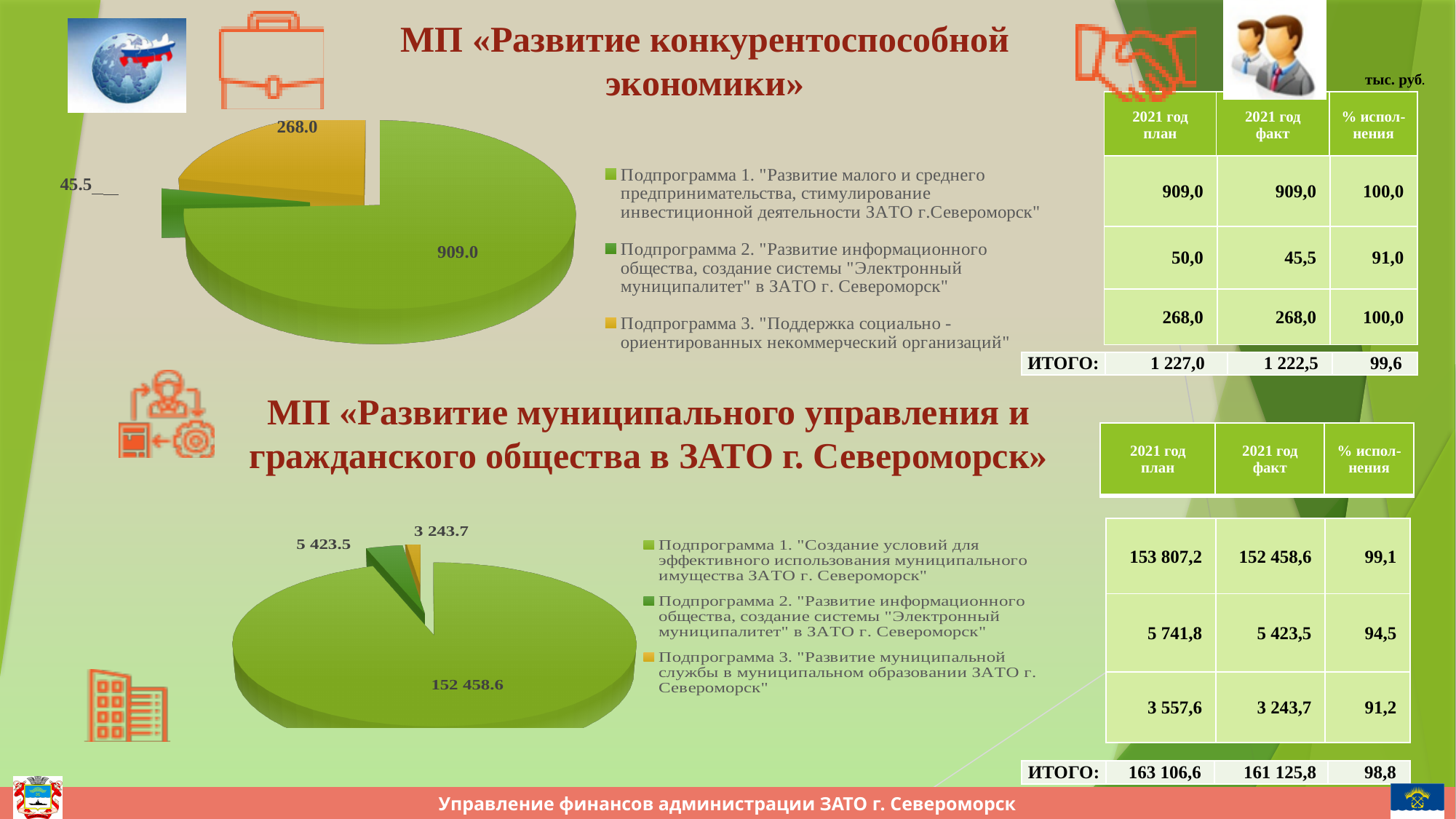
How many slices does the top pie chart («Развитие конкурентоспособной экономики») have? 3 In the top pie chart («Развитие конкурентоспособной экономики»), what is the difference between the values for Подпрограмма 1 and Подпрограмма 3? 641.0 What type of chart is used on the slide for «МП «Развитие конкурентоспособной экономики»»? Pie chart In the bottom pie chart («Развитие муниципального управления и гражданского общества»), what is the value for Подпрограмма 2? 5 423.5 In the top pie chart («Развитие конкурентоспособной экономики»), what is the value for Подпрограмма 3? 268.0 In the top pie chart («Развитие конкурентоспособной экономики»), what is the value for Подпрограмма 1? 909.0 In the top pie chart («Развитие конкурентоспособной экономики»), what is the value for Подпрограмма 2? 45.5 In the bottom pie chart («Развитие муниципального управления и гражданского общества»), which is larger: Подпрограмма 2 or Подпрограмма 3? Подпрограмма 2 In the bottom pie chart («Развитие муниципального управления и гражданского общества»), what is the value for Подпрограмма 1? 152 458.6 In the top pie chart («Развитие конкурентоспособной экономики»), which subprogram has the largest slice? Подпрограмма 1 In the top pie chart («Развитие конкурентоспособной экономики»), which subprogram has the smallest slice? Подпрограмма 2 How many entries does the legend of the bottom pie chart («Развитие муниципального управления и гражданского общества») list? 3